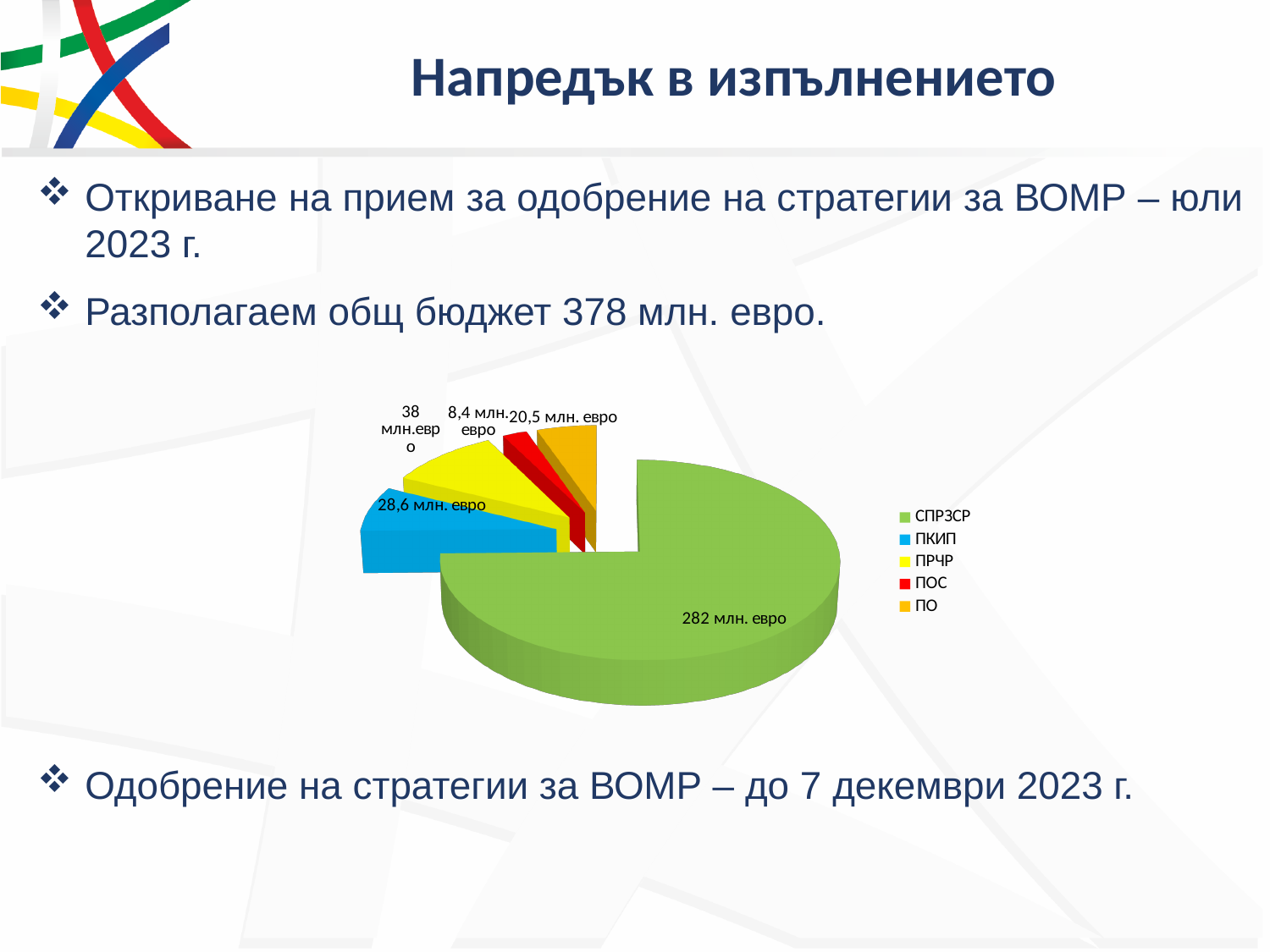
How many entries does the legend of the pie chart list? 5 What is the value shown for ПКИП in the pie chart? 28,6 млн. евро What kind of chart is shown on the slide? Pie chart What is the difference between the values for ПО and ПОС in the pie chart? 12,1 млн. евро Which category has the largest slice in the pie chart? СПРЗСР Which is larger in the pie chart, ПРЧР or ПКИП? ПРЧР What is the value shown for ПОС in the pie chart? 8,4 млн. евро What is the value shown for СПРЗСР in the pie chart? 282 млн. евро Which category has the smallest slice in the pie chart? ПОС What colour is the slice for ПКИП in the pie chart? Blue How many slices does the pie chart have? 5 What is the value shown for ПО in the pie chart? 20,5 млн. евро